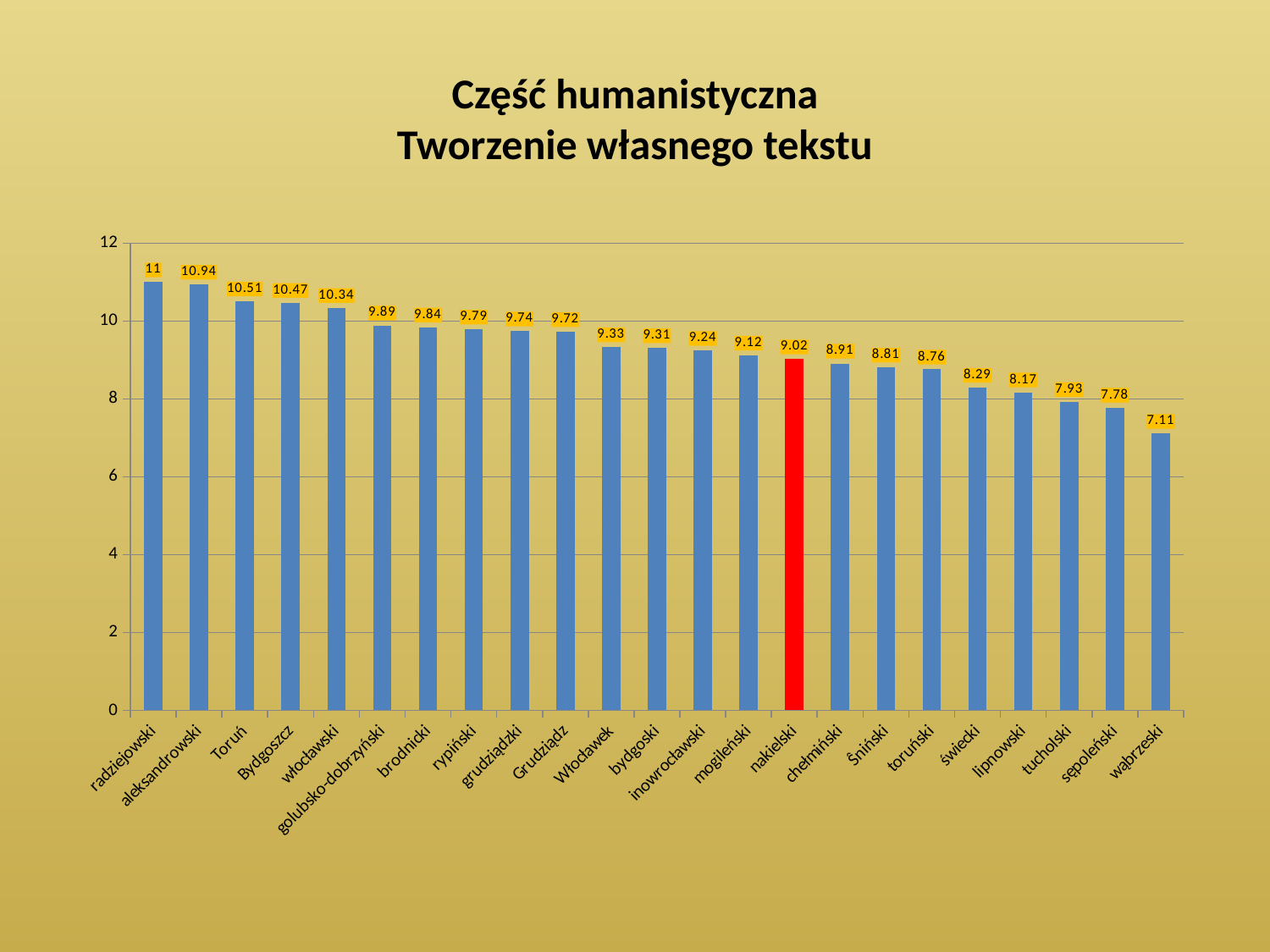
What is the value for wąbrzeski? 7.11 Which category has the highest value? radziejowski What is the difference between the values for Bydgoszcz and Toruń? 0.04 What kind of chart is shown on the slide? bar chart Which bar is coloured red instead of blue? nakielski How many categories are shown on the x axis? 23 What is the value for Toruń? 10.51 What is the value for nakielski? 9.02 Which category has the lowest value? wąbrzeski Is the value for tucholski greater or less than 8? less Which has a larger value, świecki or chełmiński? chełmiński What is the difference between the values for radziejowski and wąbrzeski? 3.89